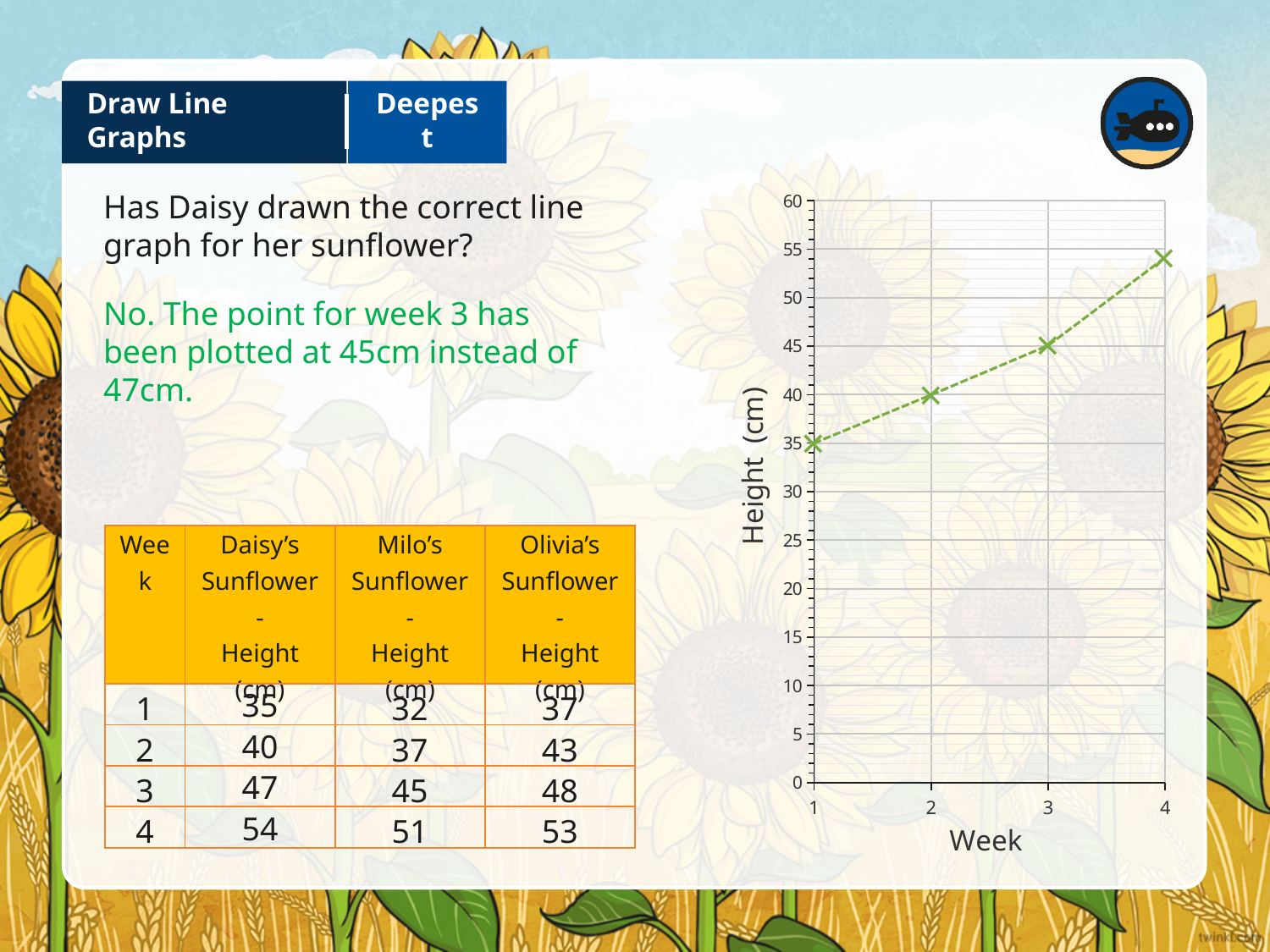
What is the label on the vertical axis of the line chart? Height (cm) What is the difference between the plotted heights for week 2 and week 1? 5 Which week has the lowest plotted height? Week 1 What height is plotted for week 1 on the line chart? 35 Which week has the highest plotted height? Week 4 What height is plotted for week 2 on the line chart? 40 Which has the larger plotted height, week 2 or week 3? Week 3 What kind of chart is shown on the slide? line chart Do the plotted values rise or fall as the weeks increase? rise Is the value plotted for week 4 greater or less than 50? greater How many data points are plotted on the line chart? 4 What height is plotted for week 3 on the line chart? 45